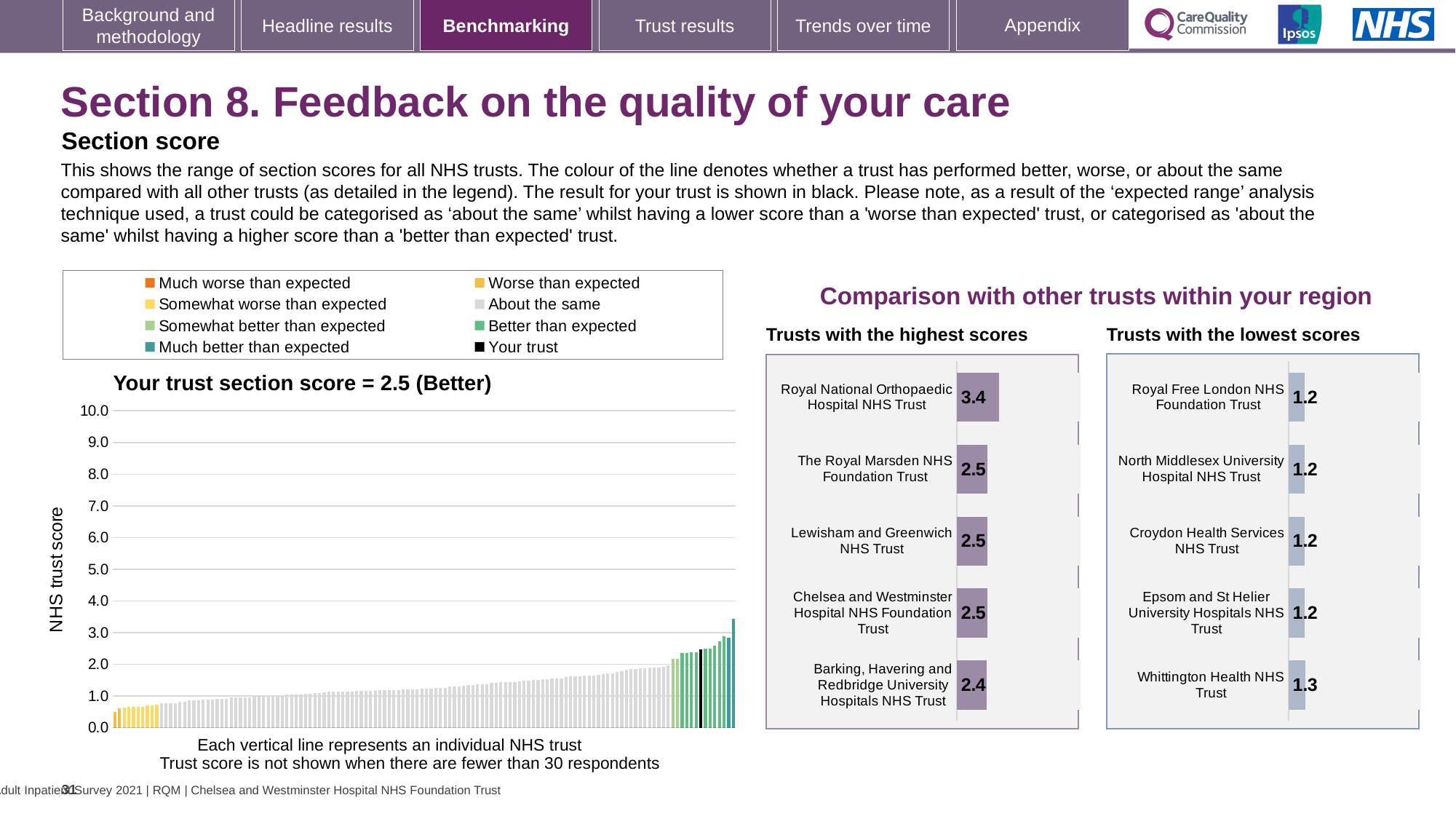
In the 'Your trust section score' chart, what is the label on the vertical axis? NHS trust score In the 'Your trust section score' chart, is the value of the tallest bar greater or less than 4.0? less How many trusts are shown in the 'Trusts with the highest scores' chart? 5 In the 'Trusts with the highest scores' chart, what is the score for Royal National Orthopaedic Hospital NHS Trust? 3.4 In the 'Trusts with the highest scores' chart, what is the difference between the scores of Royal National Orthopaedic Hospital NHS Trust and Barking, Havering and Redbridge University Hospitals NHS Trust? 1.0 How many entries does the legend above the 'Your trust section score' chart list? 8 In the 'Trusts with the lowest scores' chart, which trust has the highest score? Whittington Health NHS Trust What kind of chart is the 'Your trust section score = 2.5 (Better)' chart? bar chart In the 'Your trust section score' chart, what is the section score for your trust? 2.5 In the 'Your trust section score' chart, do the bar values rise or fall from left to right along the x axis? rise In the 'Trusts with the lowest scores' chart, what is the score for Whittington Health NHS Trust? 1.3 In the 'Trusts with the highest scores' chart, which trust has the highest score? Royal National Orthopaedic Hospital NHS Trust